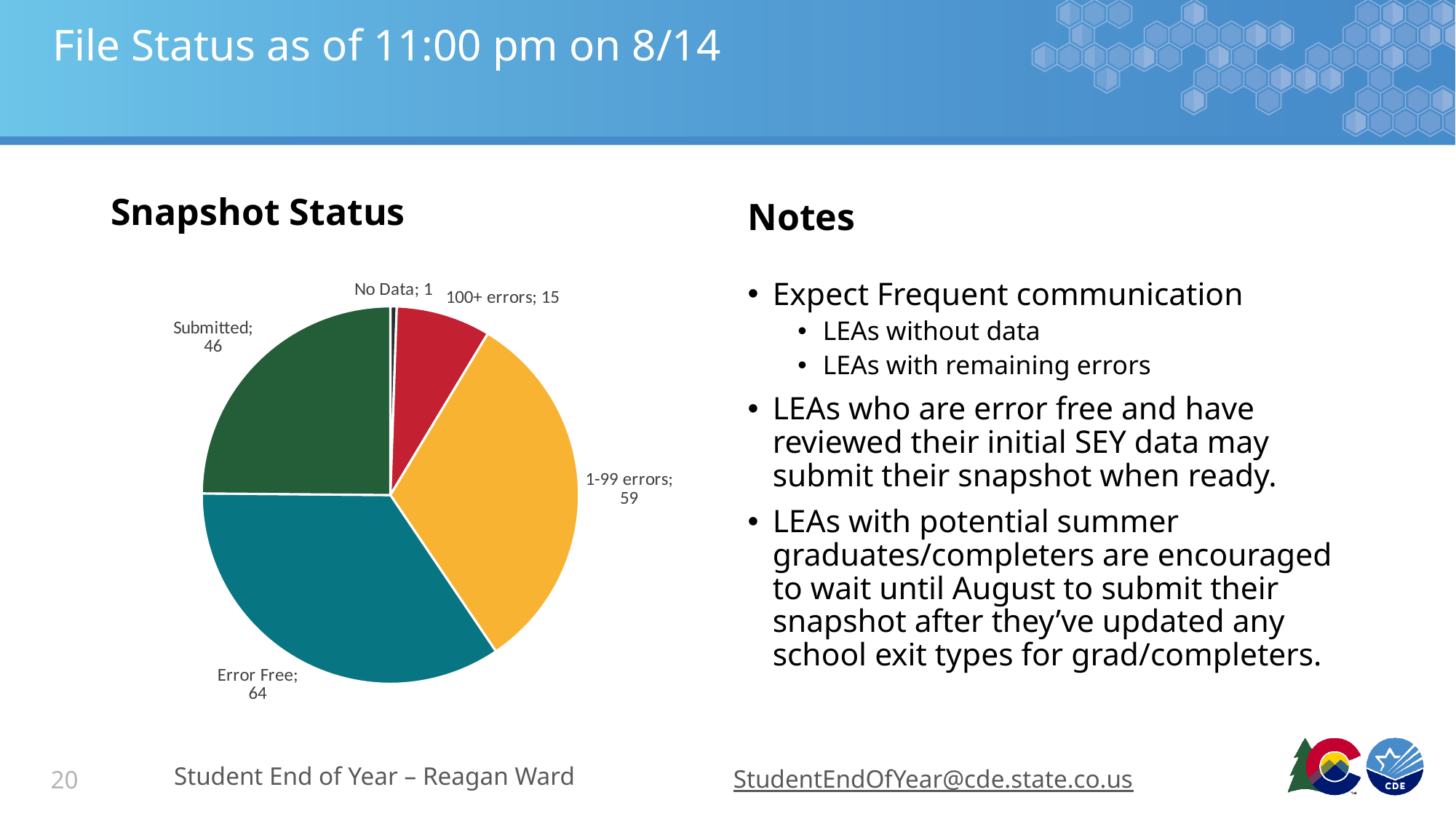
What is the value for No Data? 1 What type of chart is shown on the slide? pie chart What is the value for Error Free? 64 What is the value for 1-99 errors? 59 What is the difference between the Error Free value and the Submitted value? 18 Which is larger, 100+ errors or Submitted? Submitted How many slices does the Snapshot Status pie chart have? 5 What is the total of all slices in the pie chart? 185 Which category has the smallest slice? No Data Which category has the largest slice? Error Free What is the title of the chart? Snapshot Status What is the value for Submitted? 46